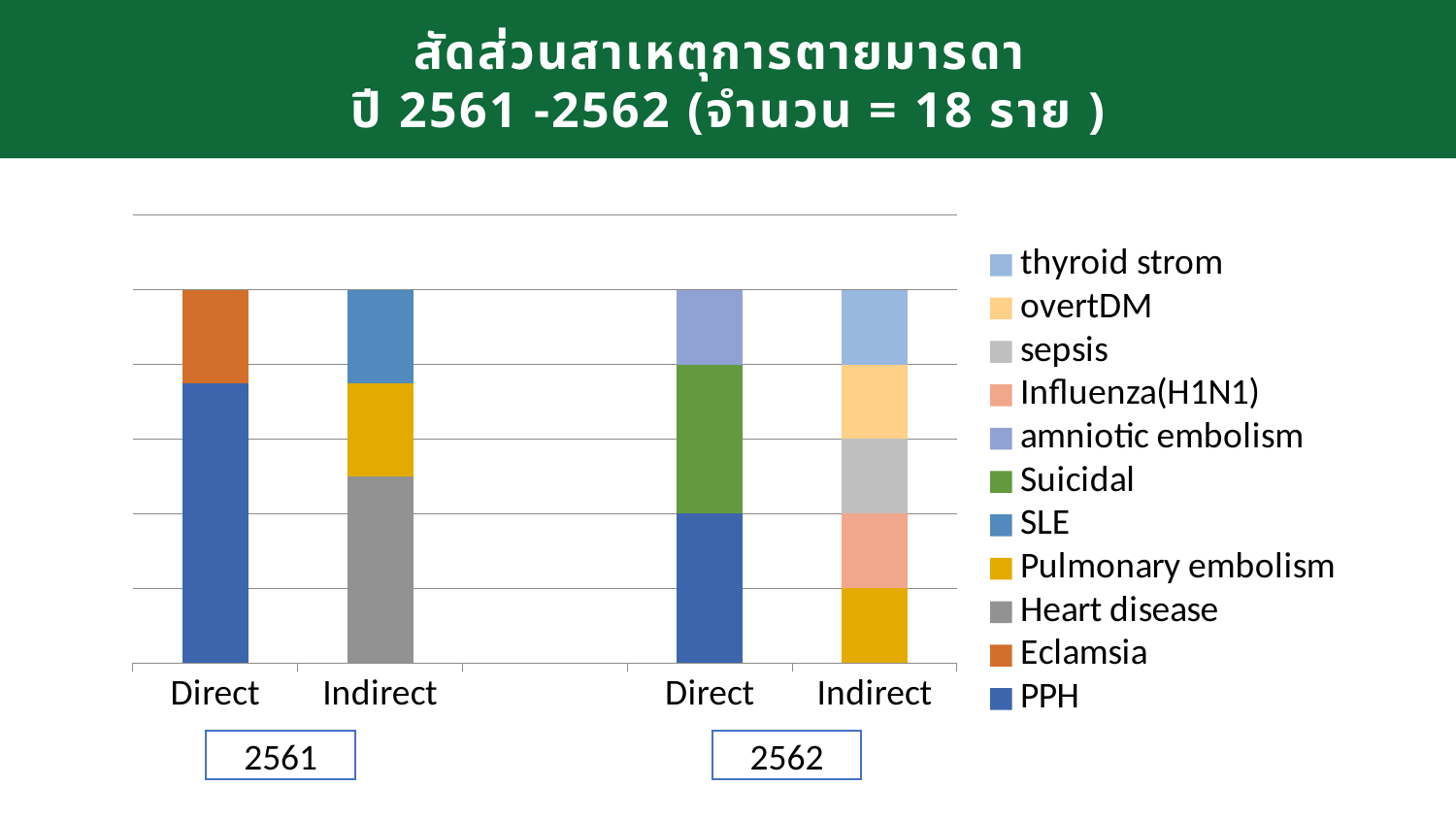
How many series does the legend list? 11 In the 2561 Direct bar, which segment is larger, PPH or Eclamsia? PPH Which series is shown in dark blue at the bottom of the Direct bars? PPH What kind of chart is shown on the slide? stacked bar chart According to the slide title, how many cases (ราย) are covered in total? 18 How many segments (causes) are stacked in the 2561 Direct bar? 2 How many segments (causes) are stacked in the 2562 Direct bar? 3 In the 2561 Indirect bar, which segment is larger, Heart disease or Pulmonary embolism? Heart disease Which cause makes up the largest segment of the 2561 Indirect bar? Heart disease How many bars are plotted in the chart? 4 In the 2562 Direct bar, which segment is larger, Suicidal or amniotic embolism? Suicidal